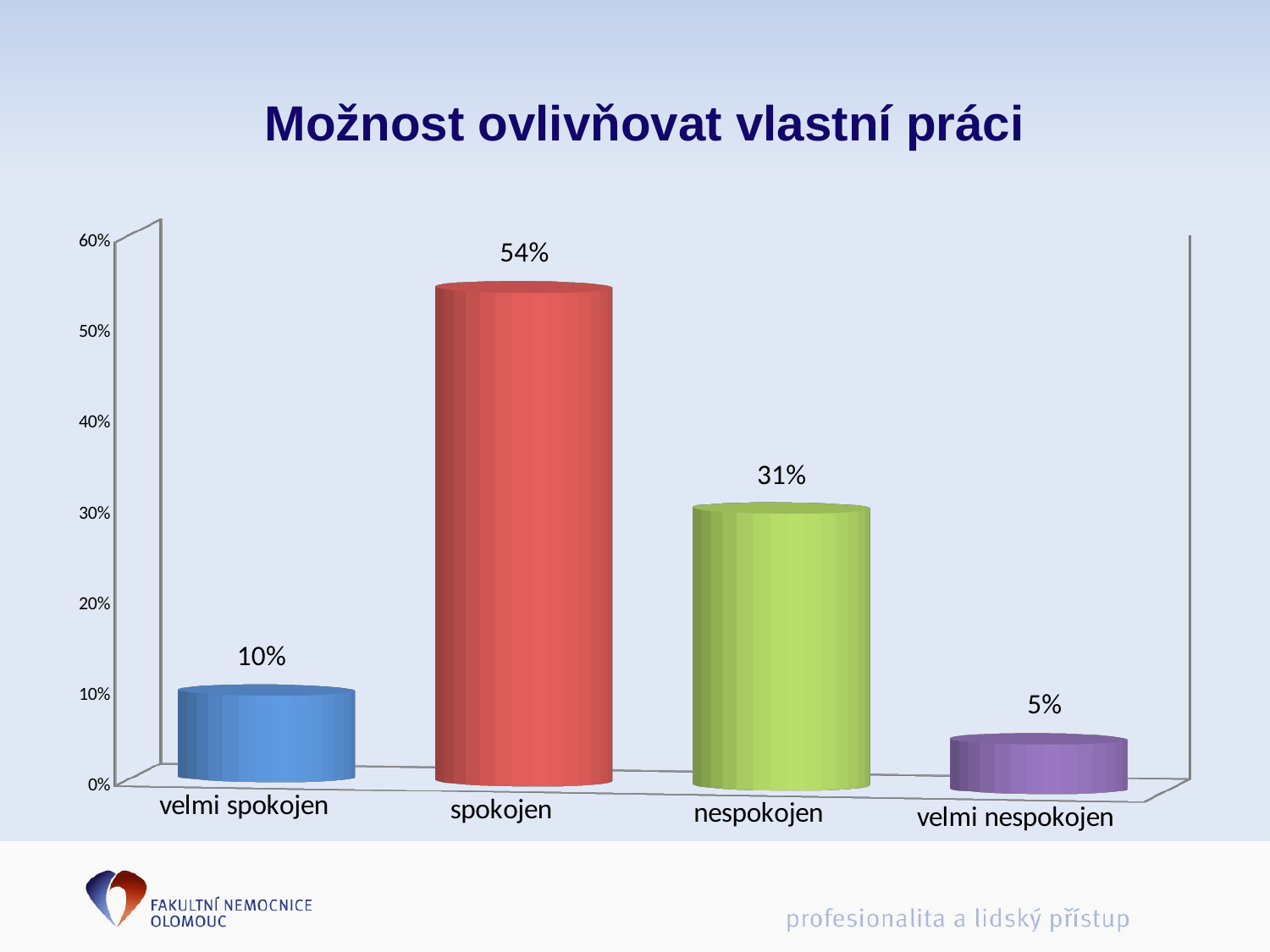
What is the difference between the values for "velmi spokojen" and "velmi nespokojen"? 5% What is the value for "velmi spokojen"? 10% What kind of chart is shown on the slide? bar chart What is the title of the chart? Možnost ovlivňovat vlastní práci What is the value for "velmi nespokojen"? 5% Which is larger, the value for "nespokojen" or the value for "velmi spokojen"? nespokojen What is the value for "spokojen"? 54% Which category has the highest value? spokojen What is the difference between the values for "spokojen" and "nespokojen"? 23% Which category has the lowest value? velmi nespokojen How many categories are shown on the x axis? 4 What is the value for "nespokojen"? 31%